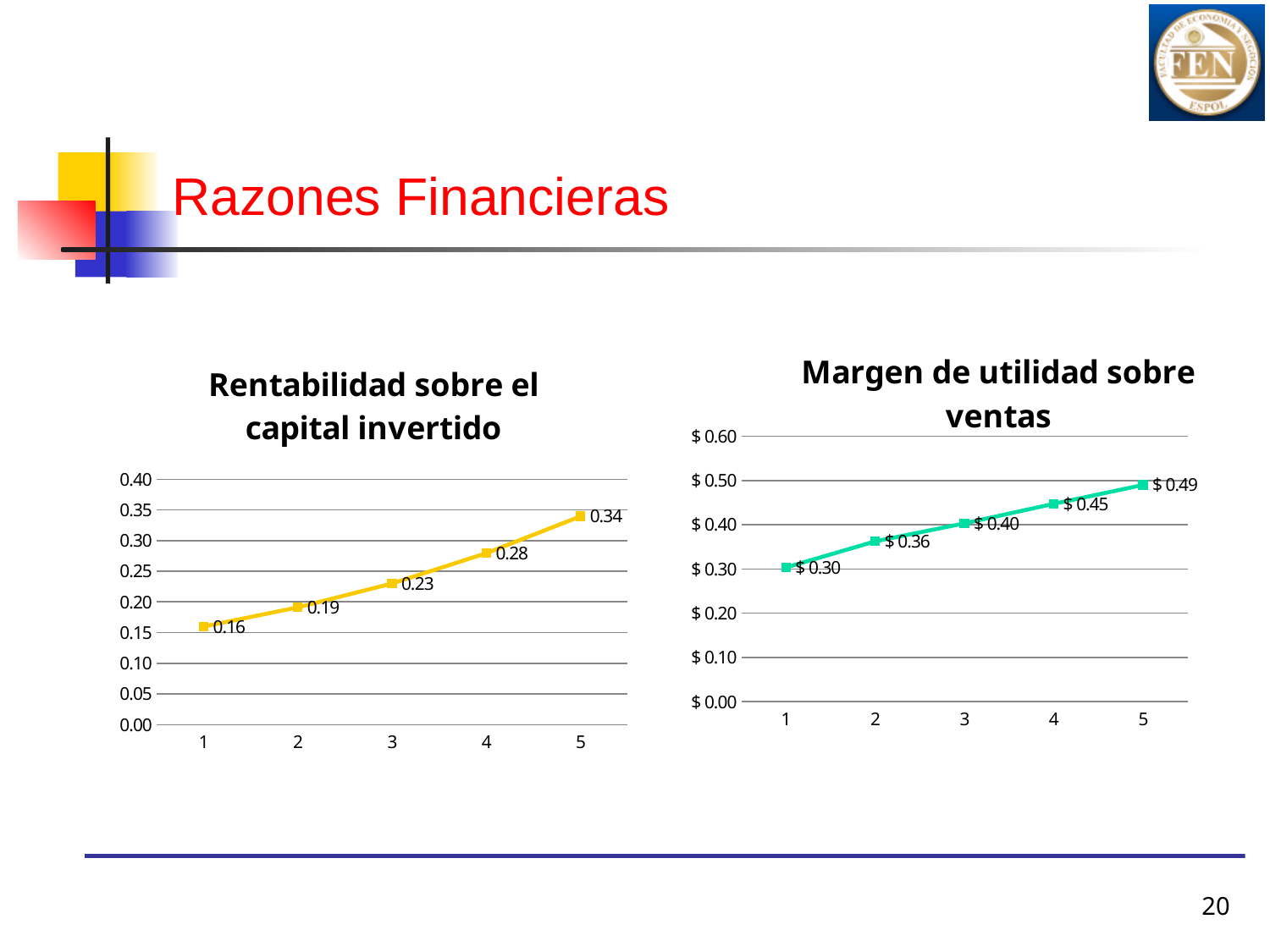
In the 'Rentabilidad sobre el capital invertido' chart, what is the difference between the values at point 5 and point 1? 0.18 In the 'Rentabilidad sobre el capital invertido' chart, which is larger: the value at point 2 or the value at point 4? point 4 In the 'Margen de utilidad sobre ventas' chart, what is the value at point 2? $ 0.36 What is the title of the chart on the right side of the slide? Margen de utilidad sobre ventas In the 'Rentabilidad sobre el capital invertido' chart, which point has the highest value? 5 In the 'Rentabilidad sobre el capital invertido' chart, what is the value at point 3? 0.23 What kind of chart is the 'Margen de utilidad sobre ventas' chart? line chart In the 'Margen de utilidad sobre ventas' chart, what is the difference between the values at point 4 and point 3? $ 0.05 In the 'Rentabilidad sobre el capital invertido' chart, do the values rise or fall from point 1 to point 5? rise In the 'Margen de utilidad sobre ventas' chart, is the value at point 5 greater or less than $ 0.40? greater In the 'Margen de utilidad sobre ventas' chart, which point has the lowest value? 1 How many data points are plotted in the 'Rentabilidad sobre el capital invertido' chart? 5